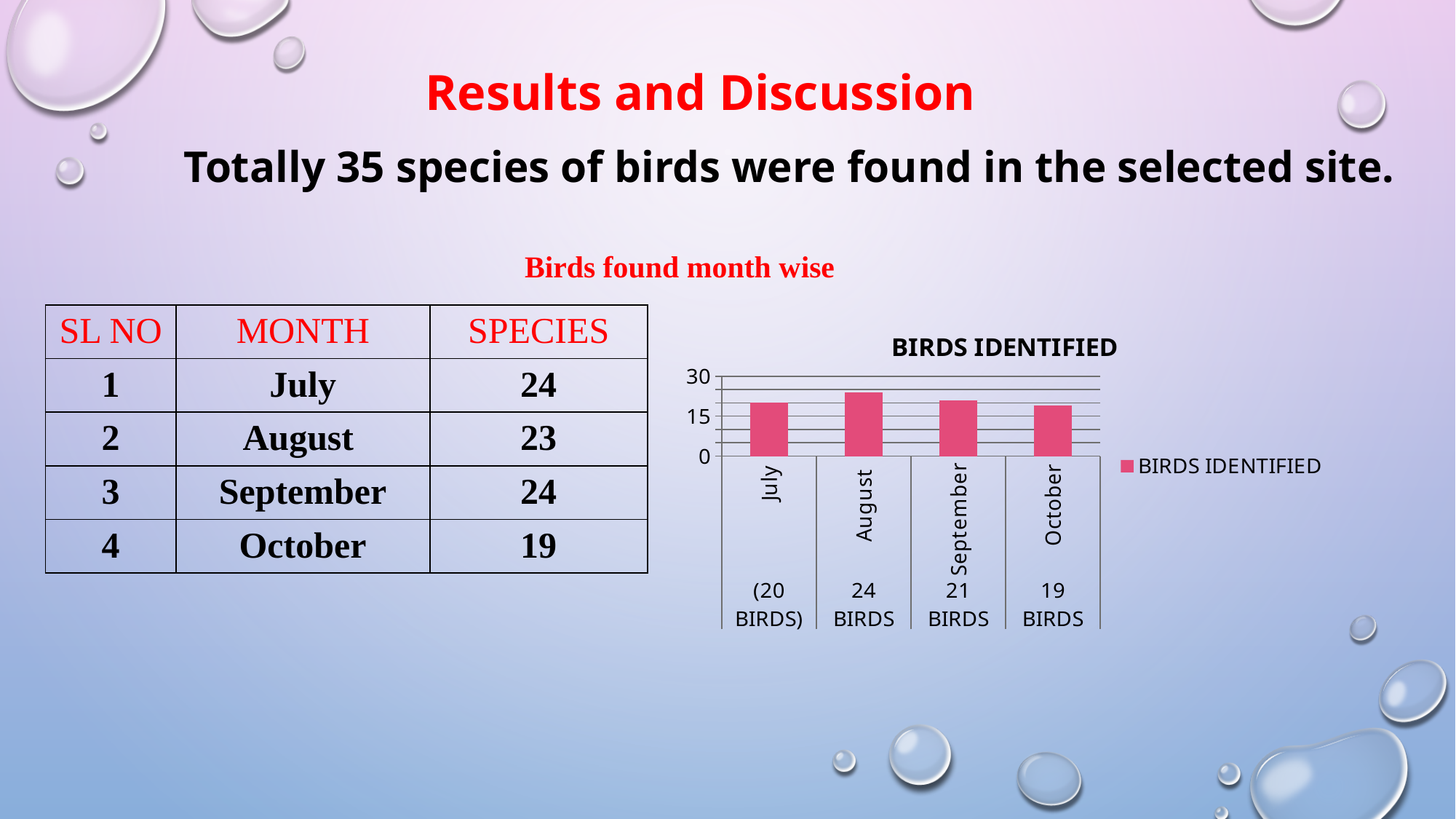
In the BIRDS IDENTIFIED chart, is the value for July greater or less than 15? greater In the BIRDS IDENTIFIED chart, how many birds are shown for September? 21 BIRDS How many months are plotted in the BIRDS IDENTIFIED chart? 4 In the BIRDS IDENTIFIED chart, how many birds are shown for August? 24 BIRDS In the BIRDS IDENTIFIED chart, do the values rise or fall from August to October? fall What kind of chart is the BIRDS IDENTIFIED chart? bar chart How many series does the legend of the BIRDS IDENTIFIED chart list? 1 In the BIRDS IDENTIFIED chart, which is larger, the value for August or the value for September? August In the BIRDS IDENTIFIED chart, how many birds are shown for October? 19 BIRDS In the BIRDS IDENTIFIED chart, what is the difference between the August and October values? 5 In the BIRDS IDENTIFIED chart, which month has the highest bar? August In the BIRDS IDENTIFIED chart, which month has the lowest bar? October